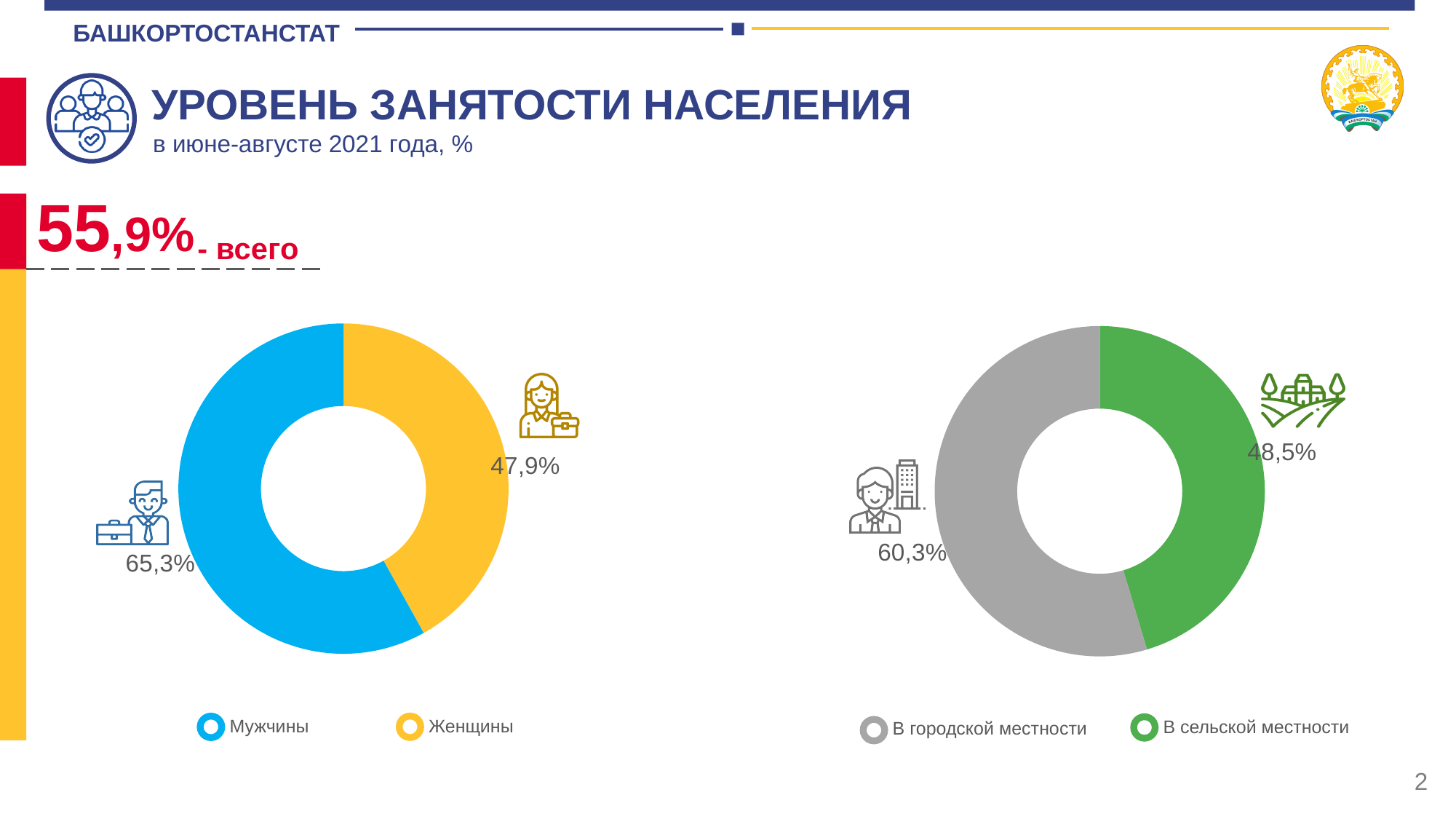
On the right chart, what is the difference between the values for В городской местности and В сельской местности? 11,8 percentage points On the left chart, what is the value for Женщины? 47,9% What is the overall employment rate (всего) shown on the slide? 55,9% How many categories does the right chart's legend list? 2 What type of chart is the left chart? Donut (pie) chart On the left chart, which colour represents Женщины? Yellow On the left chart, which category has the higher value, Мужчины or Женщины? Мужчины On the right chart, what is the value for В сельской местности? 48,5% On the right chart, which category has the lower value? В сельской местности On the left chart, what is the value for Мужчины? 65,3% On the right chart, what is the value for В городской местности? 60,3% On the left chart, what is the difference between the values for Мужчины and Женщины? 17,4 percentage points